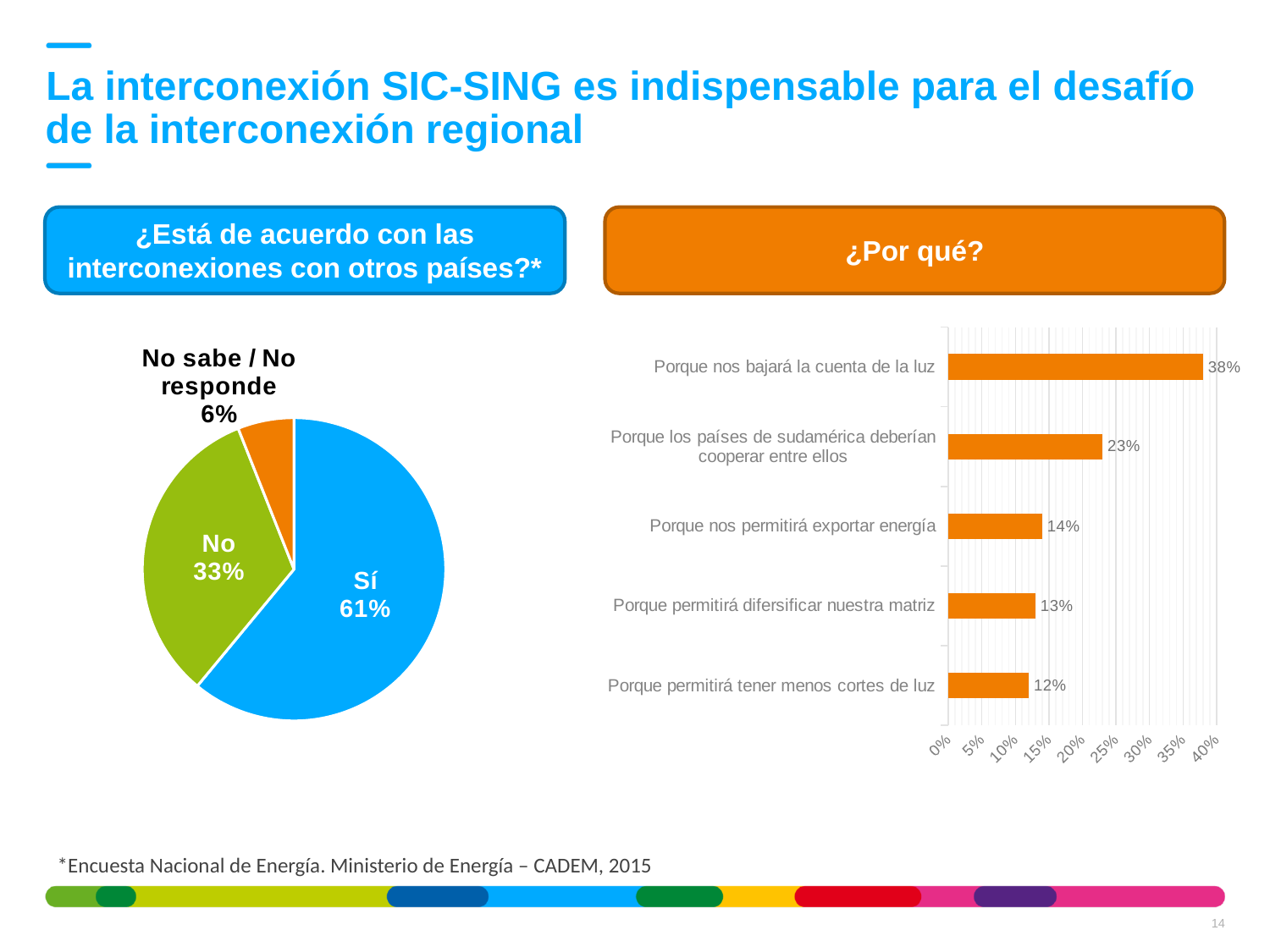
In the bar chart on the right ('¿Por qué?'), which reason has the highest value? Porque nos bajará la cuenta de la luz What type of chart is shown on the right side of the slide under '¿Por qué?'? Bar chart In the pie chart on the left, which category has the smallest slice? No sabe / No responde In the bar chart on the right ('¿Por qué?'), what is the difference between 'Porque los países de sudamérica deberían cooperar entre ellos' and 'Porque nos permitirá exportar energía'? 9% In the pie chart on the left, what is the value for 'No sabe / No responde'? 6% In the bar chart on the right ('¿Por qué?'), how many reasons are listed? 5 In the bar chart on the right ('¿Por qué?'), what is the value for 'Porque permitirá tener menos cortes de luz'? 12% In the pie chart on the left, what share of respondents answered 'Sí'? 61% In the pie chart on the left, what is the difference between the 'Sí' and 'No' shares? 28% In the pie chart on the left, what share of respondents answered 'No'? 33% In the bar chart on the right ('¿Por qué?'), what is the value for 'Porque nos bajará la cuenta de la luz'? 38% In the pie chart on the left, how many slices are there? 3